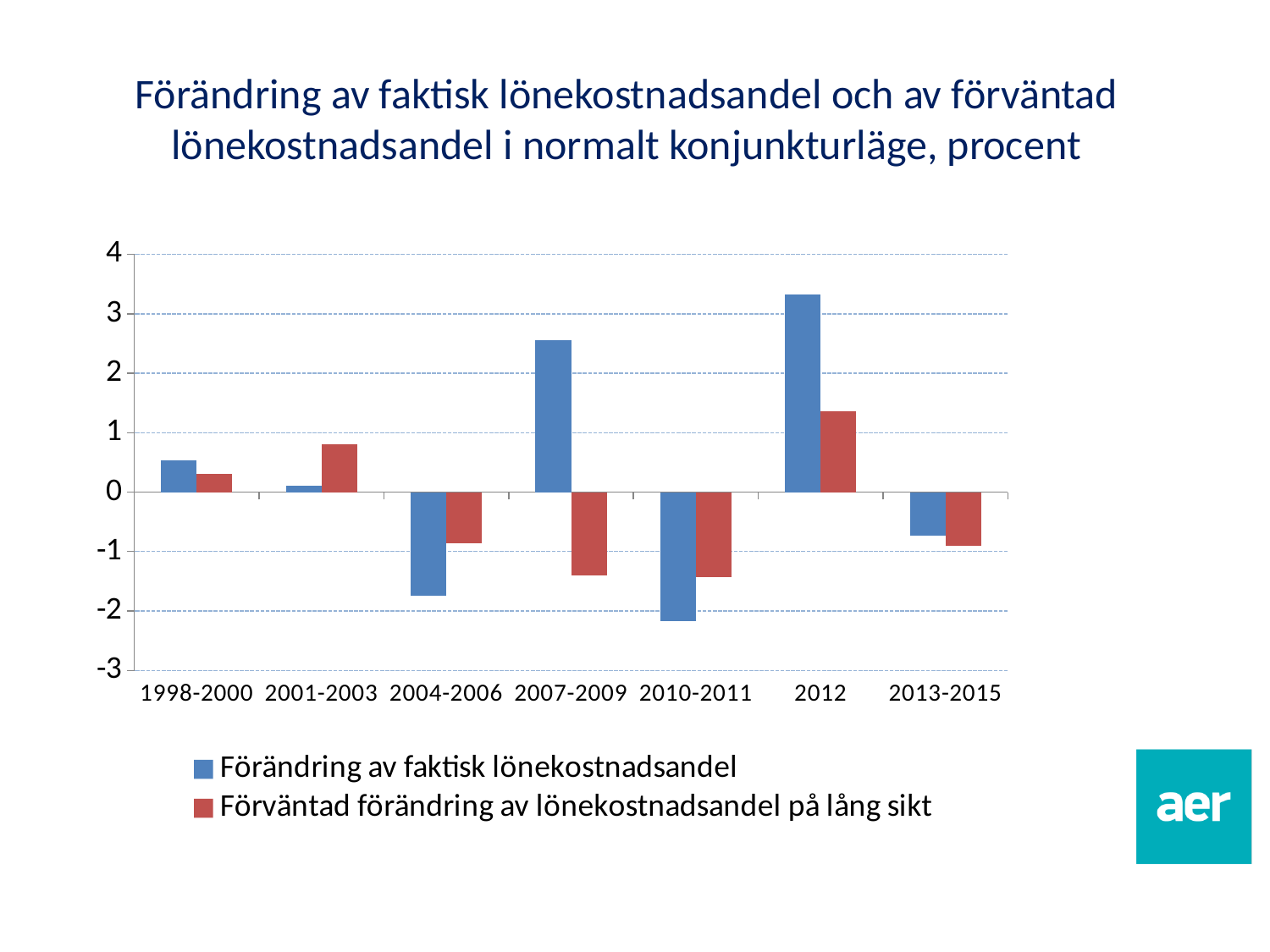
Is the value for Förändring av faktisk lönekostnadsandel in 2007-2009 greater or less than 2? greater Is the value for Förväntad förändring av lönekostnadsandel på lång sikt in 2012 greater or less than 1? greater How many period categories are shown on the x axis? 7 Which colour represents Förändring av faktisk lönekostnadsandel in the chart? blue In 2001-2003, which series has the larger value: Förändring av faktisk lönekostnadsandel or Förväntad förändring av lönekostnadsandel på lång sikt? Förväntad förändring av lönekostnadsandel på lång sikt In which period is the value for Förväntad förändring av lönekostnadsandel på lång sikt highest? 2012 In which period is the value for Förändring av faktisk lönekostnadsandel lowest? 2010-2011 What kind of chart is shown on the slide? bar chart Is the value for Förändring av faktisk lönekostnadsandel in 2010-2011 greater or less than -2? less How many series does the legend list? 2 In which period is the value for Förändring av faktisk lönekostnadsandel highest? 2012